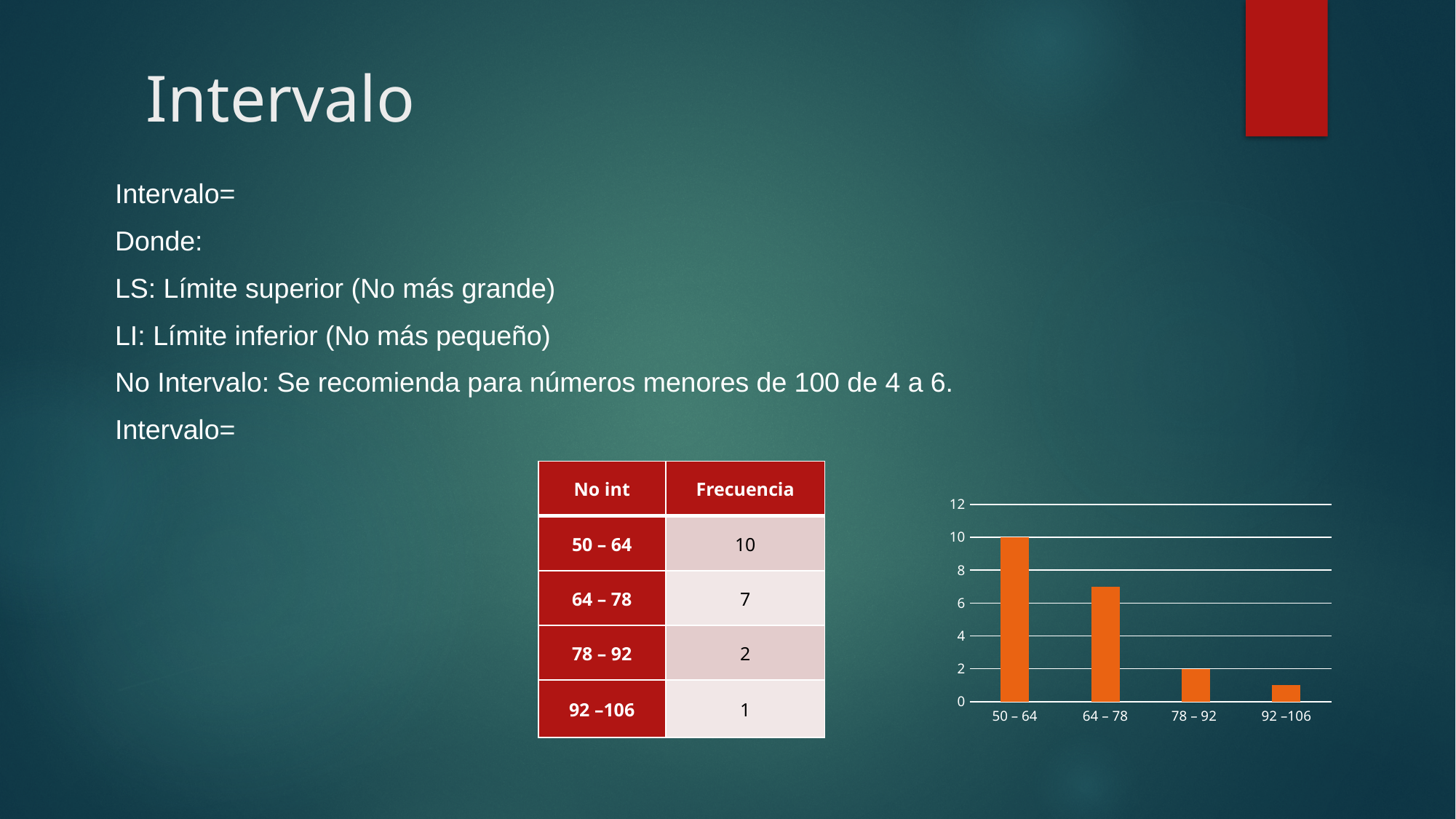
Is the value for 64 – 78 greater or less than 6? greater How many categories are shown on the x axis of the chart? 4 What is the value of the bar for 50 – 64? 10 What type of chart is shown on the slide? bar chart Which is larger, the bar for 64 – 78 or the bar for 78 – 92? 64 – 78 Do the bar values rise or fall from left to right along the x axis? fall Which category has the highest bar in the chart? 50 – 64 Which category has the lowest bar in the chart? 92 –106 What is the value of the bar for 92 –106? 1 What is the value of the bar for 78 – 92? 2 What is the difference between the values for 50 – 64 and 78 – 92? 8 What is the value of the bar for 64 – 78? 7